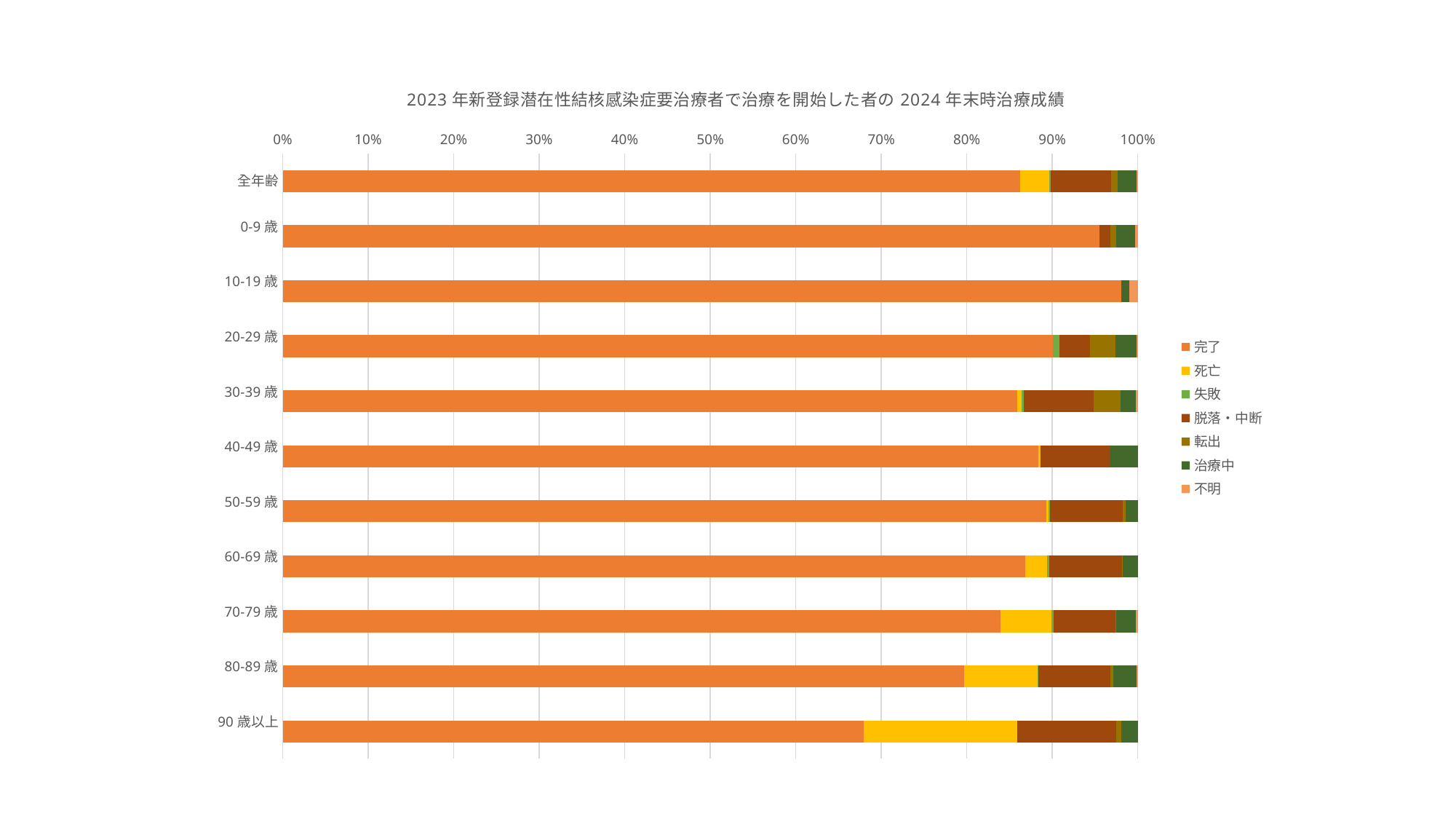
Which age category has the highest share of 完了? 10-19歳 Is the 完了 share for 70-79歳 greater or less than 80%? greater Is the 完了 share for 10-19歳 greater or less than 90%? greater How many age categories are plotted on the chart? 11 What kind of chart is shown on the slide? bar chart Does the 完了 share rise or fall going from 60-69歳 to 90歳以上? fall Which age category has the largest 死亡 segment? 90歳以上 Which has a larger 完了 share, 80-89歳 or 90歳以上? 80-89歳 How many series does the legend list? 7 Is the 完了 share for 全年齢 greater or less than 80%? greater Which age category has the lowest share of 完了? 90歳以上